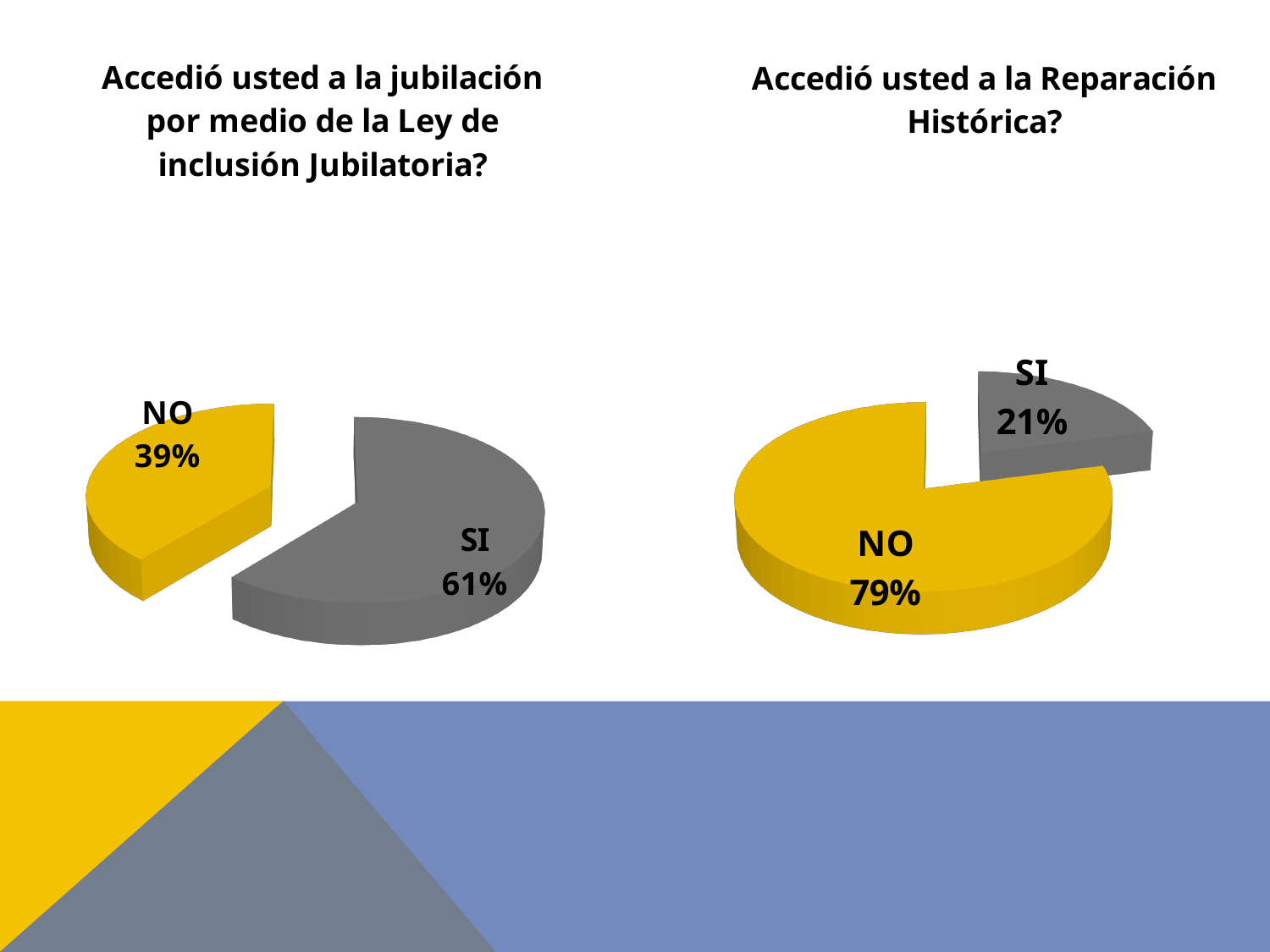
In the chart titled 'Accedió usted a la Reparación Histórica?', what share is labelled for SI? 21% In the left chart, which slice is the largest? SI In the left chart, what is the difference in percentage points between SI and NO? 22 How many slices does the left chart have? 2 In the chart titled 'Accedió usted a la jubilación por medio de la Ley de inclusión Jubilatoria?', what share is labelled for NO? 39% What kind of chart is used on the right side of the slide? Pie chart In the chart titled 'Accedió usted a la jubilación por medio de la Ley de inclusión Jubilatoria?', what share is labelled for SI? 61% In the chart titled 'Accedió usted a la Reparación Histórica?', what share is labelled for NO? 79% In the right chart, which is larger, SI or NO? NO In the right chart, what is the difference in percentage points between NO and SI? 58 In the right chart, what colour is the NO slice? Yellow In the right chart, which slice is the smallest? SI